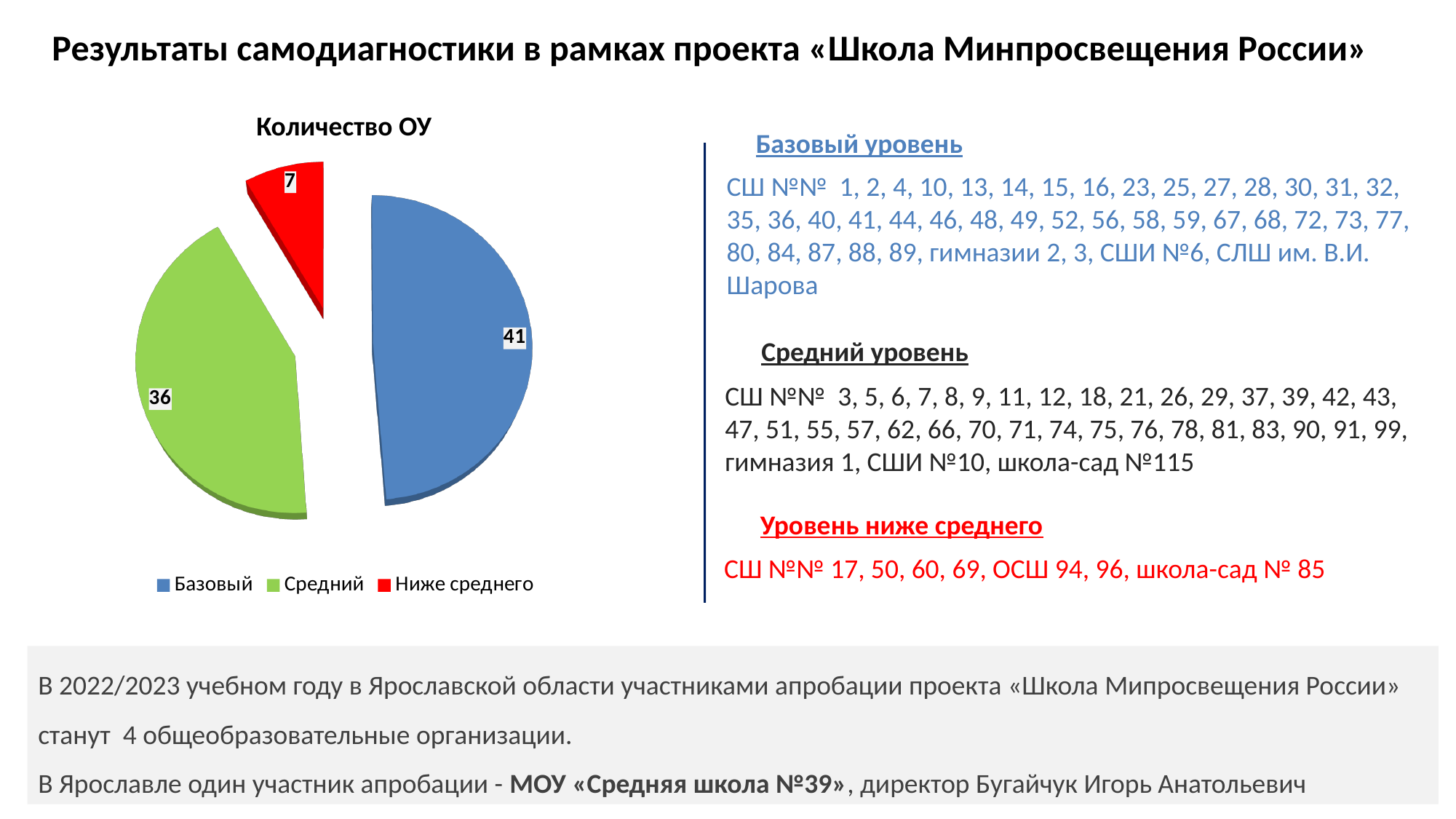
What is the difference between the Средний and Ниже среднего values? 29 What is the value for the Средний slice? 36 Which category has the largest slice? Базовый How many slices does the pie chart have? 3 What is the difference between the Базовый and Средний values? 5 Which is larger, the Базовый slice or the Ниже среднего slice? Базовый What is the value for the Базовый slice? 41 What is the title of the chart? Количество ОУ What is the value for the Ниже среднего slice? 7 Which category has the smallest slice? Ниже среднего What type of chart is shown on the slide? pie chart What is the total of all slices in the pie chart? 84